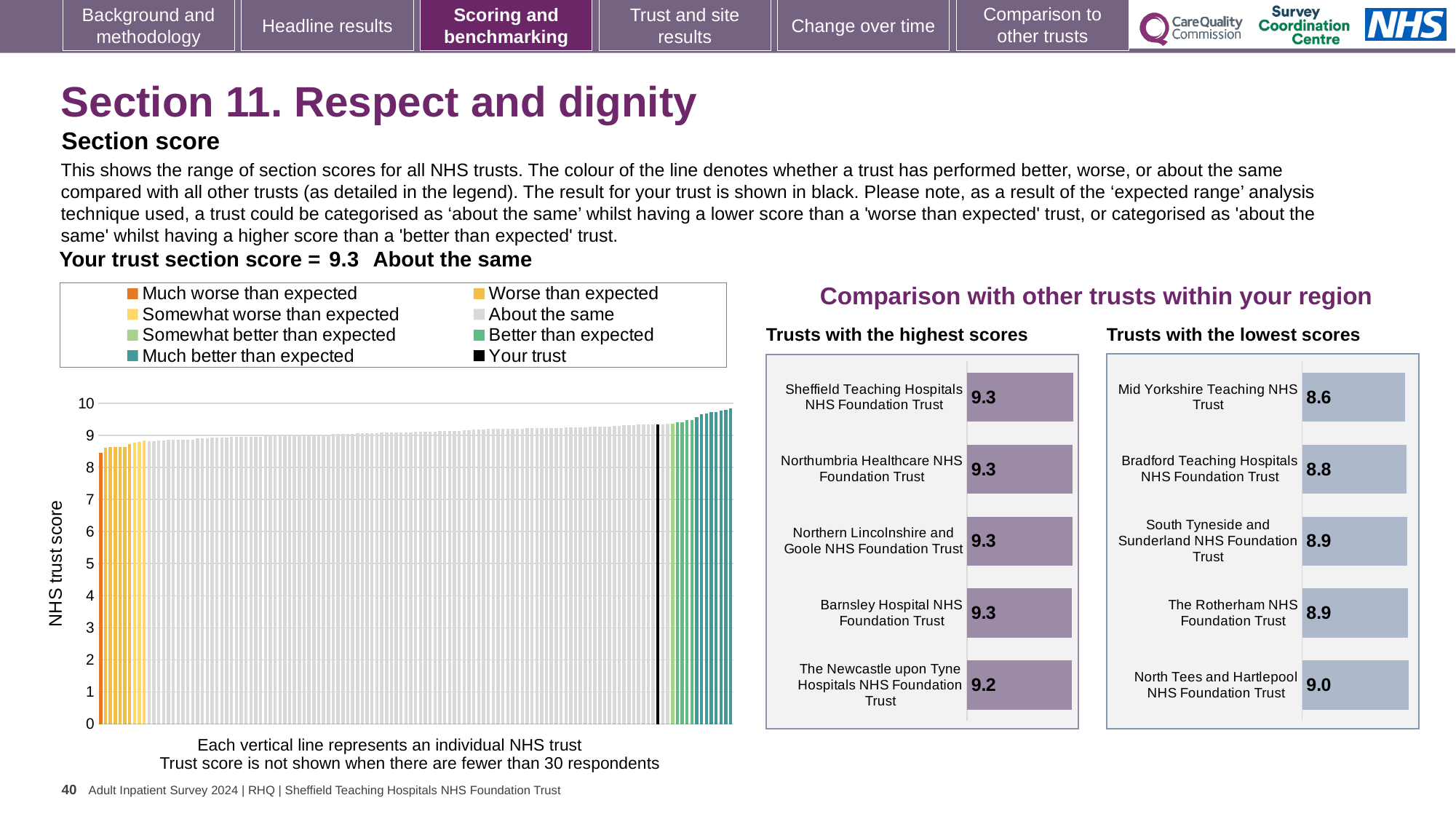
In the 'Trusts with the lowest scores' chart, which has the higher score: Bradford Teaching Hospitals NHS Foundation Trust or South Tyneside and Sunderland NHS Foundation Trust? South Tyneside and Sunderland NHS Foundation Trust In the 'Trusts with the highest scores' chart, what is the score for The Newcastle upon Tyne Hospitals NHS Foundation Trust? 9.2 According to the slide, what is your trust's section score for Respect and dignity? 9.3 In the 'Trusts with the lowest scores' chart, which trust has the highest score? North Tees and Hartlepool NHS Foundation Trust In the 'Trusts with the lowest scores' chart, what is the score for Bradford Teaching Hospitals NHS Foundation Trust? 8.8 In the left-hand NHS trust score chart, do the values rise or fall from left to right? Rise How many entries does the legend of the left-hand NHS trust score chart list? 8 In the 'Trusts with the lowest scores' chart, what is the difference between the scores of North Tees and Hartlepool NHS Foundation Trust and Mid Yorkshire Teaching NHS Trust? 0.4 In the 'Trusts with the lowest scores' chart, which trust has the lowest score? Mid Yorkshire Teaching NHS Trust In the 'Trusts with the lowest scores' chart, what is the score for Mid Yorkshire Teaching NHS Trust? 8.6 How many trusts are shown in the 'Trusts with the highest scores' chart? 5 What type of chart is the large chart on the left showing NHS trust scores? Bar chart